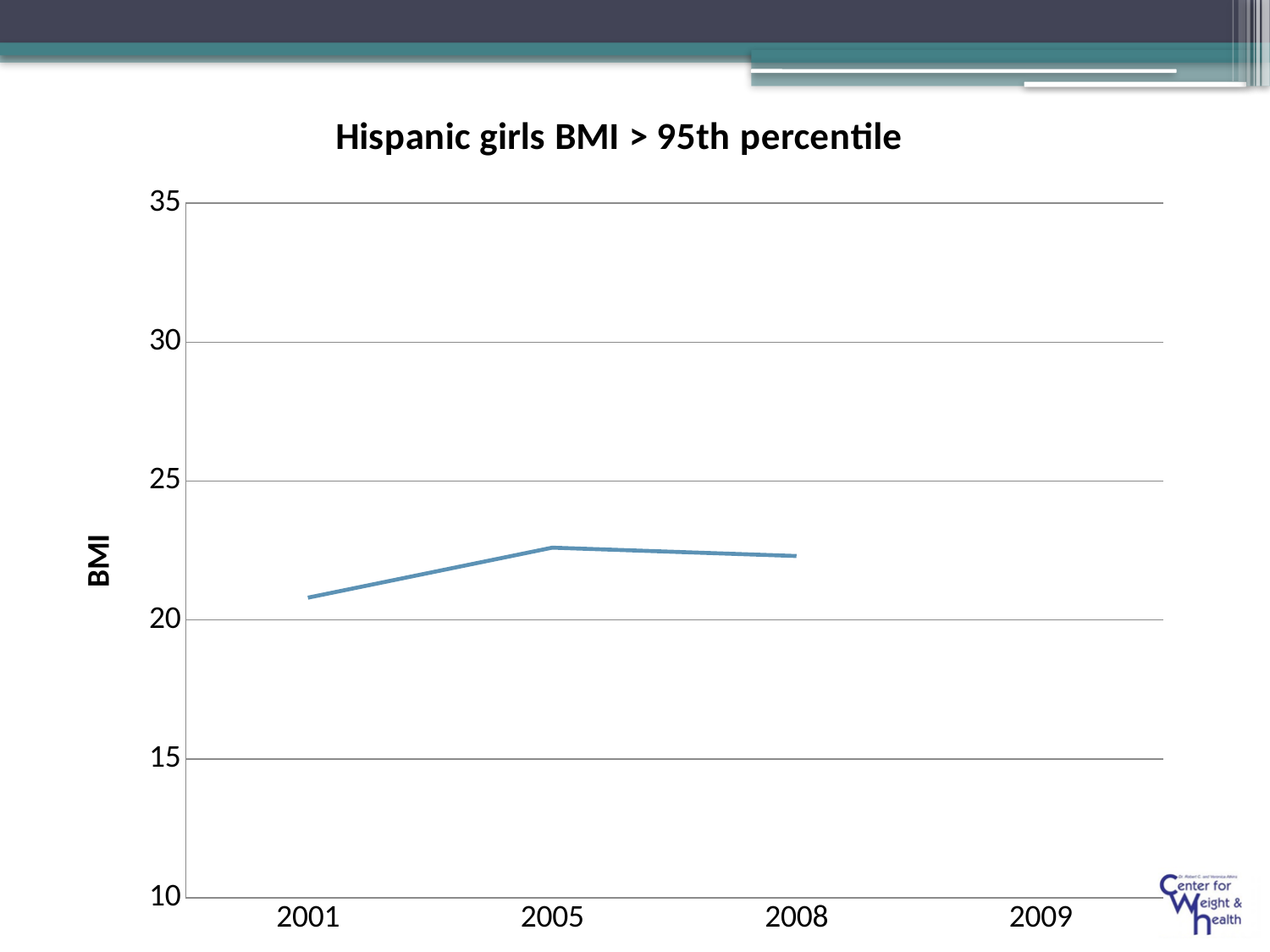
What is the label on the vertical axis of the chart? BMI Which year has the lowest plotted BMI value? 2001 Is the value for 2008 greater or less than 20? greater Which year labeled on the x axis has no plotted value on the line? 2009 Is the value for 2001 greater or less than 25? less Is the value for 2005 greater or less than 25? less Which is larger, the value for 2001 or the value for 2005? 2005 What kind of chart is shown on the slide? line chart How many years are labeled on the x axis? 4 What is the title of the chart? Hispanic girls BMI > 95th percentile Does the line rise or fall from 2001 to 2005? rise